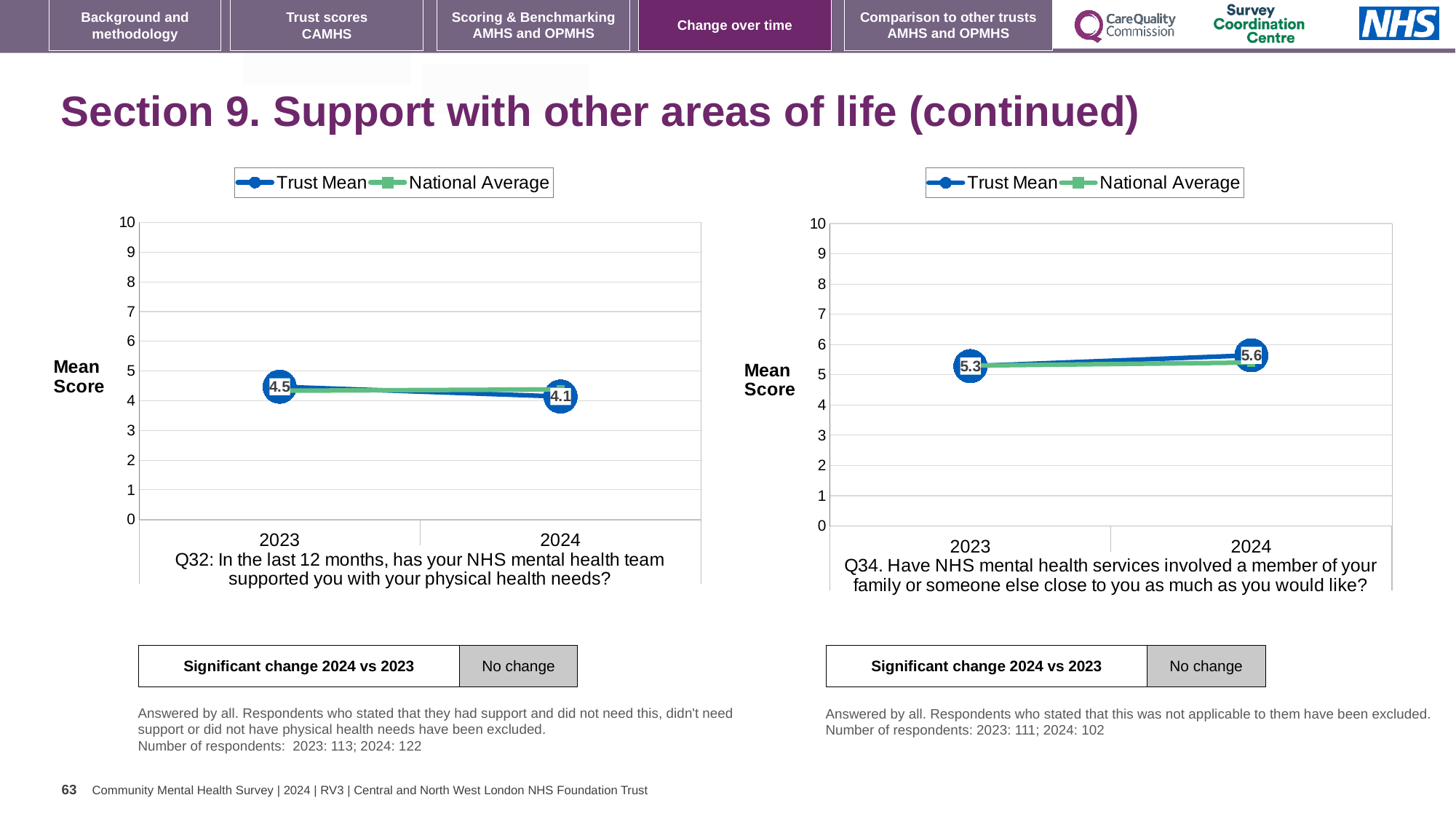
In the right chart (Q34), is the Trust Mean for 2024 greater or less than 5? greater In the right chart (Q34), what is the difference between the Trust Mean for 2024 and 2023? 0.3 In the left chart (Q32), does the Trust Mean rise or fall from 2023 to 2024? fall In the left chart (Q32), what is the Trust Mean for 2024? 4.1 What type of chart is the left chart (Q32)? line chart In the left chart (Q32), by how much did the Trust Mean change from 2023 to 2024? 0.4 In the left chart (Q32), which year has the higher Trust Mean, 2023 or 2024? 2023 In the right chart (Q34), does the Trust Mean rise or fall from 2023 to 2024? rise How many series does the legend of the right chart (Q34) list? 2 In the left chart (Q32), what is the Trust Mean for 2023? 4.5 In the right chart (Q34), what is the Trust Mean for 2023? 5.3 In the right chart (Q34), what is the Trust Mean for 2024? 5.6